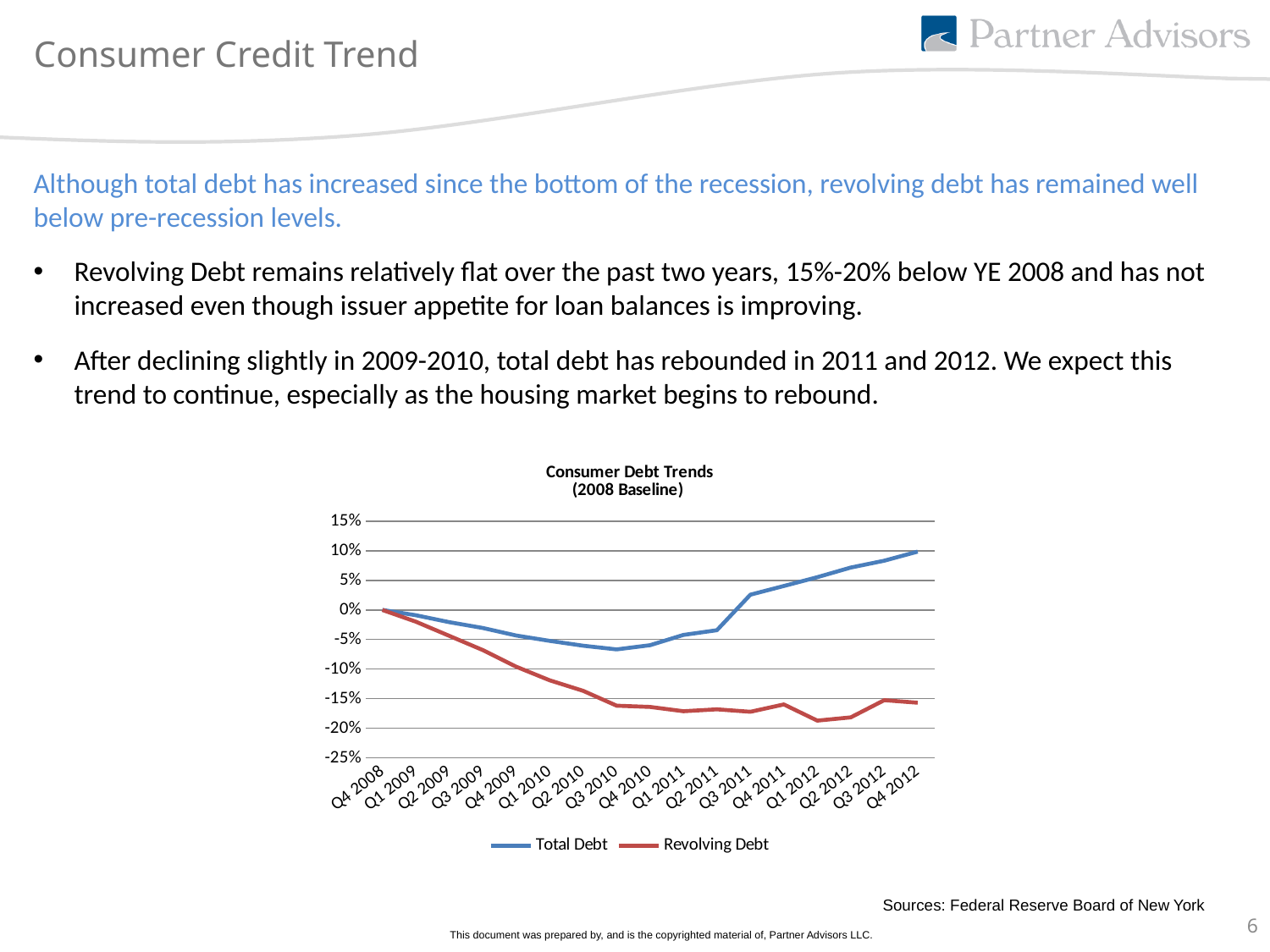
Is the value for Revolving Debt at Q4 2012 greater or less than -10%? less What is the title of the chart? Consumer Debt Trends (2008 Baseline) What is the value of Revolving Debt at Q4 2008? 0% What is the value of Total Debt at Q4 2008? 0% How many series does the chart legend list? 2 How many quarters are plotted along the x axis of the chart? 17 What kind of chart is shown on the slide? Line chart At which quarter does Total Debt reach its highest value? Q4 2012 Does Revolving Debt rise or fall from Q4 2008 to Q4 2010? Fall Is the value for Total Debt at Q4 2012 greater or less than 5%? greater Is the value for Revolving Debt at Q1 2012 greater or less than -15%? less At Q4 2012, which series has the larger value, Total Debt or Revolving Debt? Total Debt